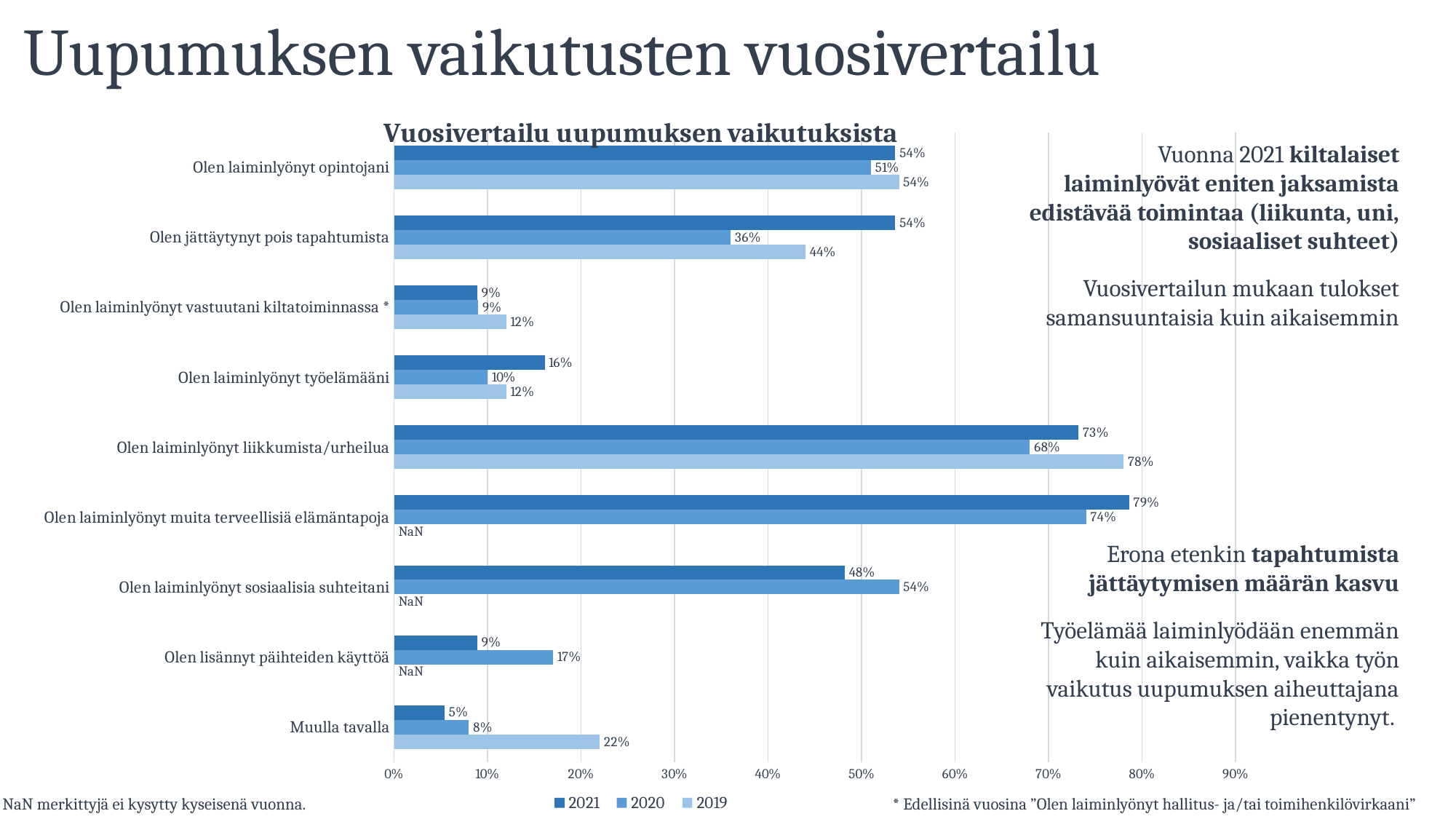
Which series is shown in the lightest blue in the legend? 2019 What is the 2019 value for "Muulla tavalla"? 22% What is the difference between the 2021 and 2020 values for "Olen jättäytynyt pois tapahtumista"? 18% What is the title of the chart? Vuosivertailu uupumuksen vaikutuksista Which category has the highest 2021 value? Olen laiminlyönyt muita terveellisiä elämäntapoja How many categories are shown on the y axis of the chart? 9 Which category has the lowest 2021 value? Muulla tavalla What is the 2021 value for "Olen jättäytynyt pois tapahtumista"? 54% How many series does the legend list? 3 What kind of chart is shown on the slide? Bar chart What is the 2020 value for "Olen laiminlyönyt liikkumista/urheilua"? 68% Which is larger for "Olen laiminlyönyt sosiaalisia suhteitani": the 2021 value or the 2020 value? 2020